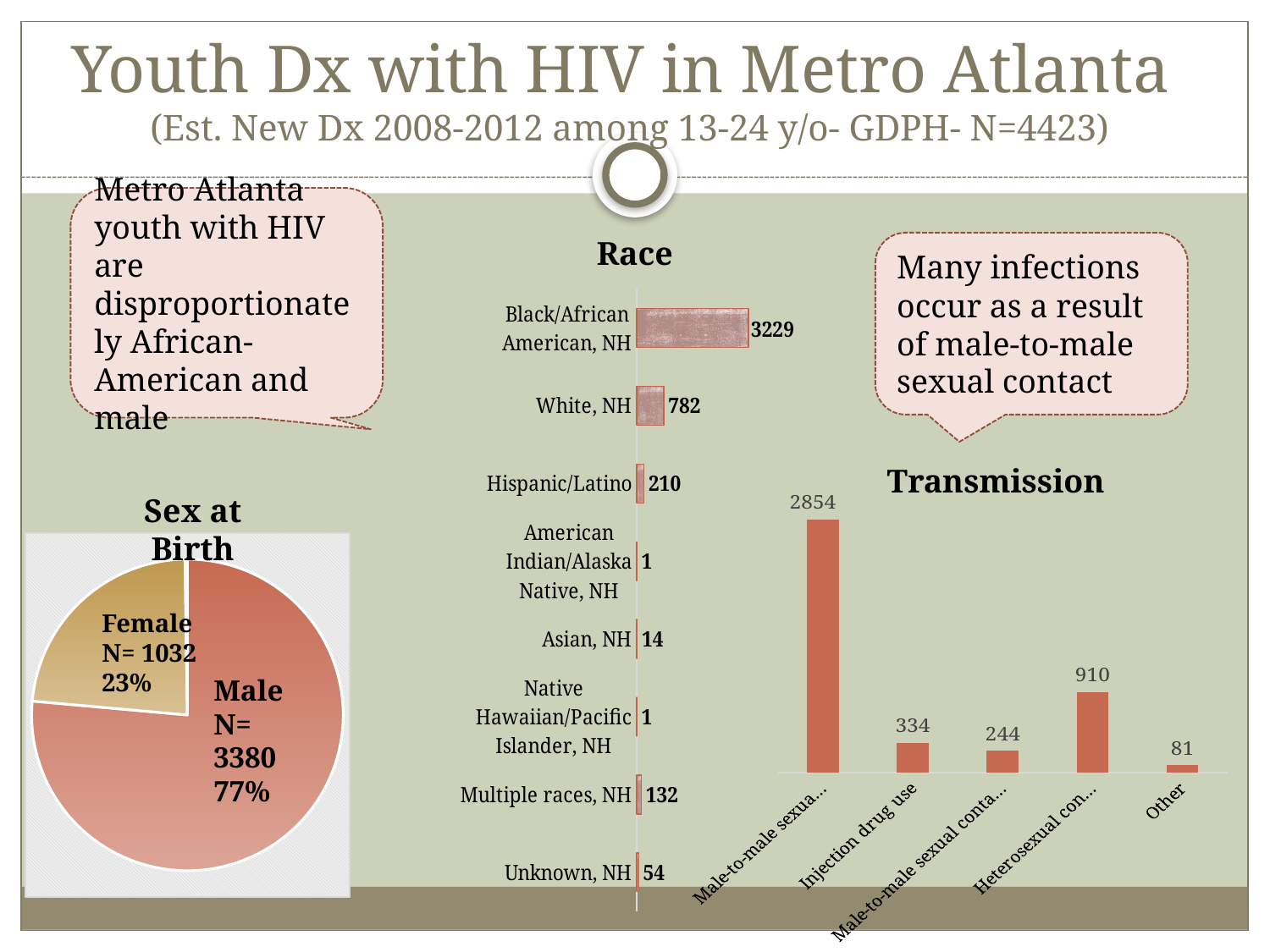
In the Race chart, what is the value for Hispanic/Latino? 210 In the Transmission chart, what is the value for Injection drug use? 334 In the Sex at Birth chart, what share of the pie is Female? 23% In the Race chart, which is larger, the value for Multiple races, NH or the value for Unknown, NH? Multiple races, NH What kind of chart is the Transmission chart? Bar chart In the Transmission chart, which category has the lowest value? Other In the Race chart, what is the difference between the values for Black/African American, NH and White, NH? 2447 In the Transmission chart, how many bars are shown? 5 In the Race chart, what is the value for White, NH? 782 In the Race chart, how many categories are shown? 8 In the Sex at Birth chart, what is the N value for Male? 3380 In the Race chart, which category has the highest value? Black/African American, NH